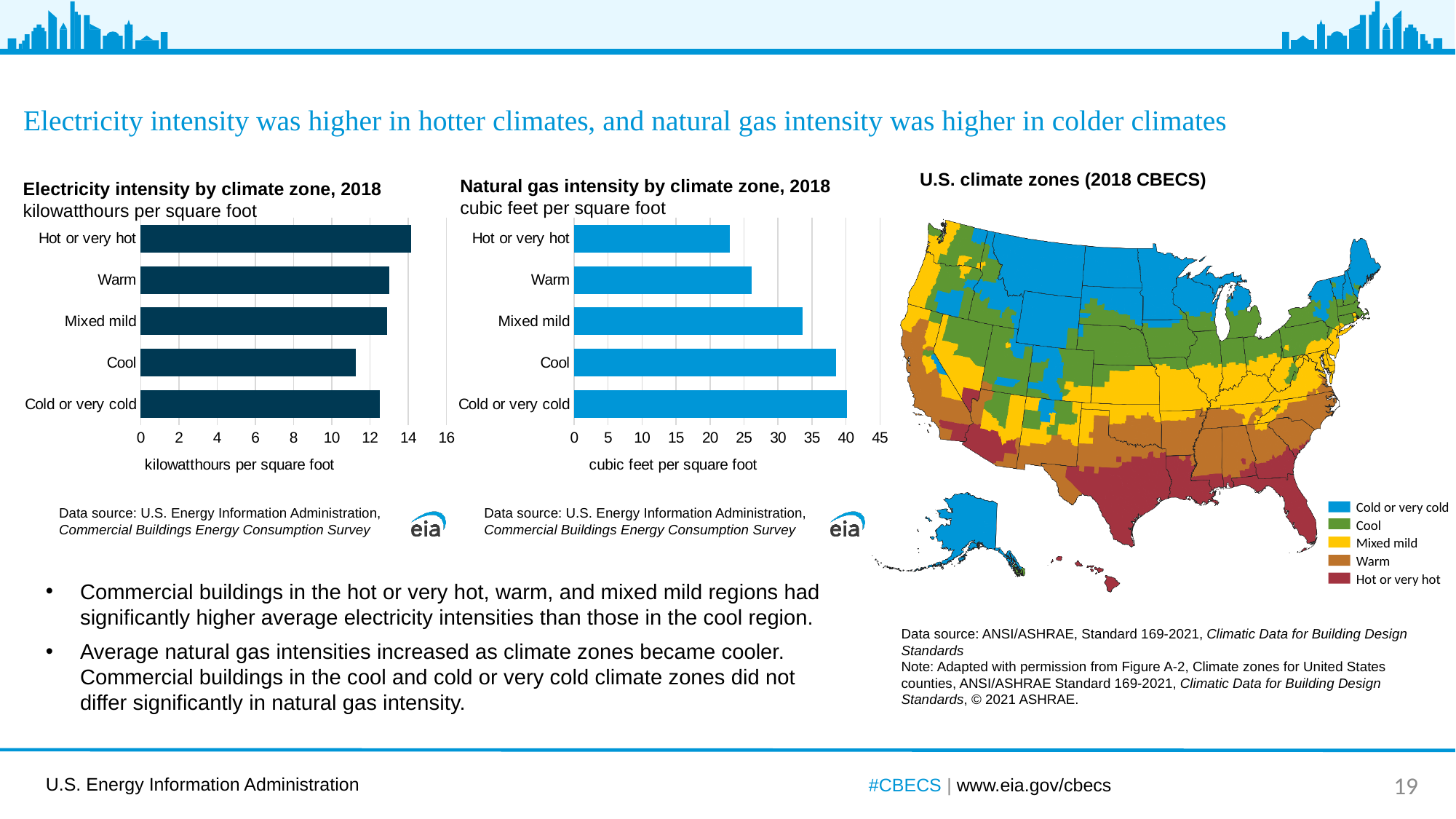
What kind of chart is the 'Electricity intensity by climate zone, 2018' chart? bar chart In the 'Electricity intensity by climate zone, 2018' chart, which is larger, the value for Hot or very hot or the value for Cold or very cold? Hot or very hot In the 'Electricity intensity by climate zone, 2018' chart, which climate zone has the lowest electricity intensity? Cool In the 'Natural gas intensity by climate zone, 2018' chart, which is larger, the value for Mixed mild or the value for Warm? Mixed mild In the 'Electricity intensity by climate zone, 2018' chart, which climate zone has the highest electricity intensity? Hot or very hot What unit is shown on the x axis of the 'Natural gas intensity by climate zone, 2018' chart? cubic feet per square foot In the 'Natural gas intensity by climate zone, 2018' chart, is the value for Cool greater or less than 35? greater In the 'Natural gas intensity by climate zone, 2018' chart, is the value for Warm greater or less than 30? less In the 'Electricity intensity by climate zone, 2018' chart, is the value for Hot or very hot greater or less than 12? greater How many climate zones are shown in the 'Natural gas intensity by climate zone, 2018' chart? 5 In the 'Natural gas intensity by climate zone, 2018' chart, which climate zone has the lowest natural gas intensity? Hot or very hot